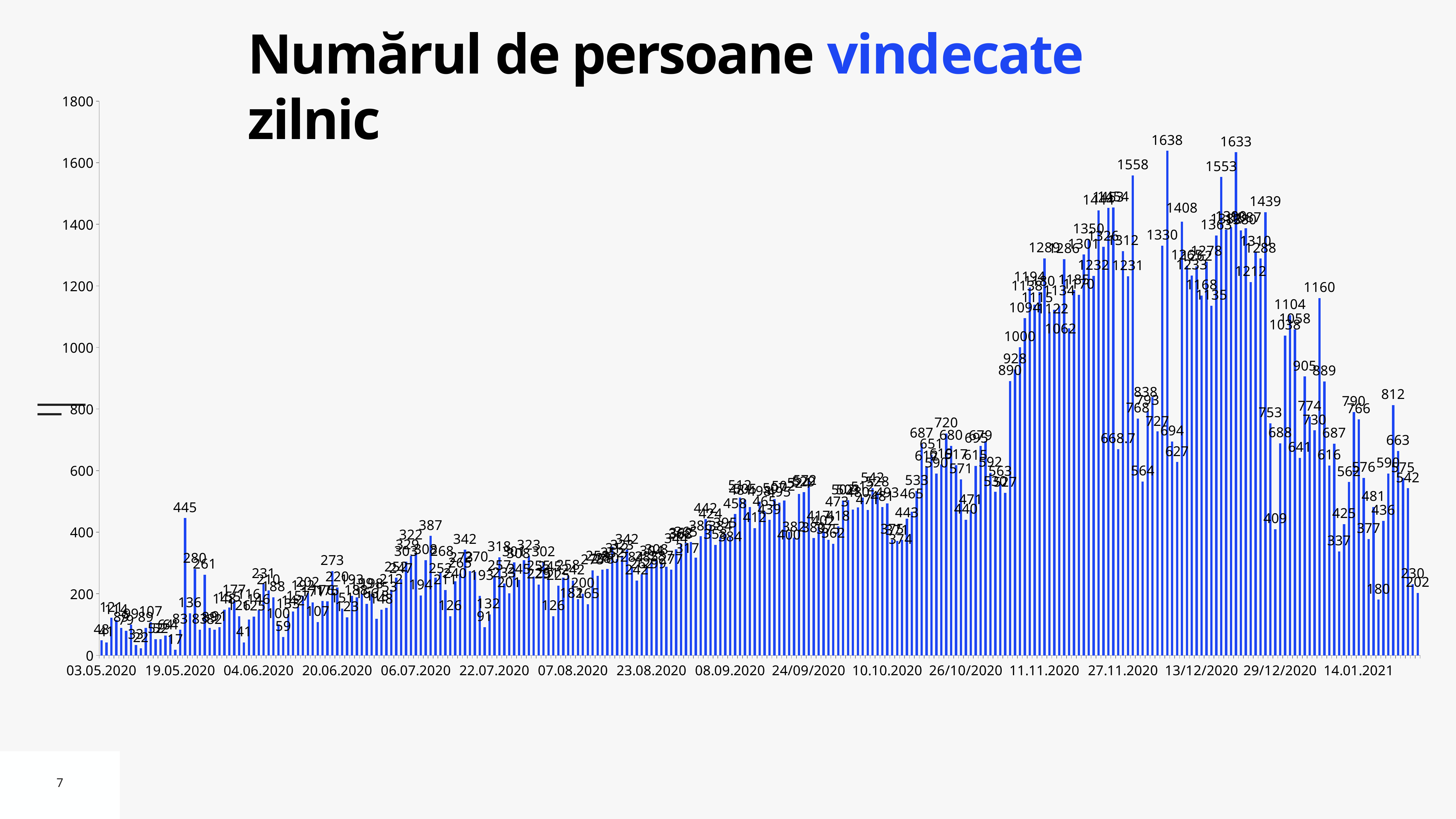
What is the value of the tallest bar in the May 2020 section of the chart (the spike shortly after 19.05.2020)? 445 What is the title of the chart? Numărul de persoane vindecate zilnic Is the first bar on the chart (at 03.05.2020) greater or less than 200? less What is the maximum value shown on the y axis? 1800 What is the highest daily value labelled on the chart? 1638 Overall, do the daily values rise or fall from May 2020 to November 2020? rise What kind of chart is shown on the slide? bar chart What is the value labelled on the last bar at the right end of the chart? 202 What is the first date shown on the x axis? 03.05.2020 Which is larger, the bar labelled 1558 or the bar labelled 1553? 1558 What is the difference between the two highest labelled values, 1638 and 1633? 5 Is the highest bar on the chart greater or less than 1600? greater